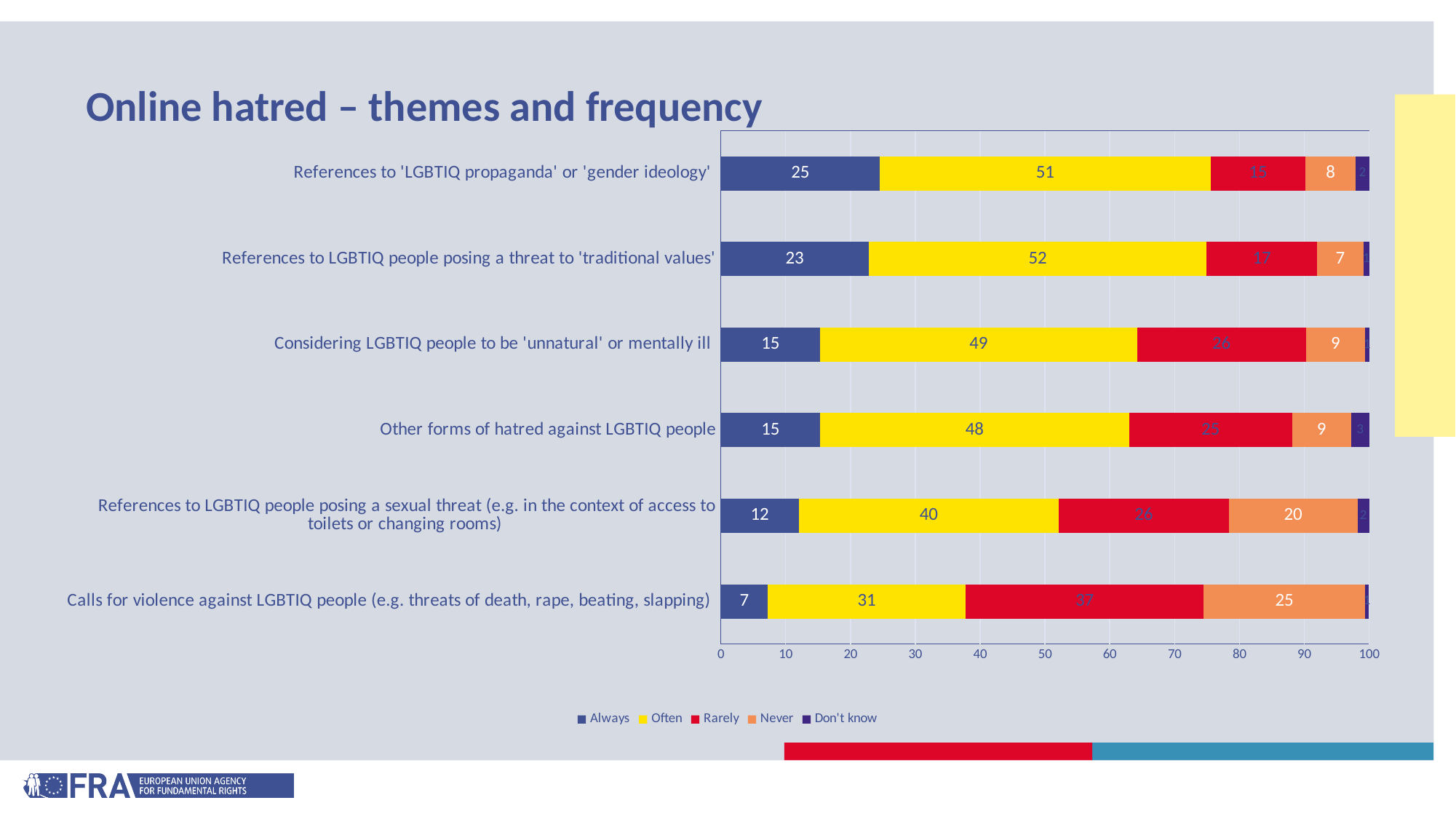
Which category has the lowest 'Often' value? Calls for violence against LGBTIQ people (e.g. threats of death, rape, beating, slapping) How many series does the legend list? 5 What is the 'Always' value for 'References to 'LGBTIQ propaganda' or 'gender ideology''? 25 What is the difference between the 'Often' values for 'Considering LGBTIQ people to be 'unnatural' or mentally ill' and 'Calls for violence against LGBTIQ people (e.g. threats of death, rape, beating, slapping)'? 18 Which category has the highest 'Always' value? References to 'LGBTIQ propaganda' or 'gender ideology' Which is larger: the 'Never' value for 'Other forms of hatred against LGBTIQ people' or the 'Never' value for 'Calls for violence against LGBTIQ people (e.g. threats of death, rape, beating, slapping)'? Calls for violence against LGBTIQ people (e.g. threats of death, rape, beating, slapping) What is the 'Often' value for 'References to LGBTIQ people posing a threat to 'traditional values''? 52 What is the 'Never' value for 'References to LGBTIQ people posing a sexual threat (e.g. in the context of access to toilets or changing rooms)'? 20 What is the 'Rarely' value for 'Calls for violence against LGBTIQ people (e.g. threats of death, rape, beating, slapping)'? 37 What is the title of the chart on the slide? Online hatred – themes and frequency How many categories (themes) are plotted in the chart? 6 What kind of chart is shown on the slide? Stacked bar chart